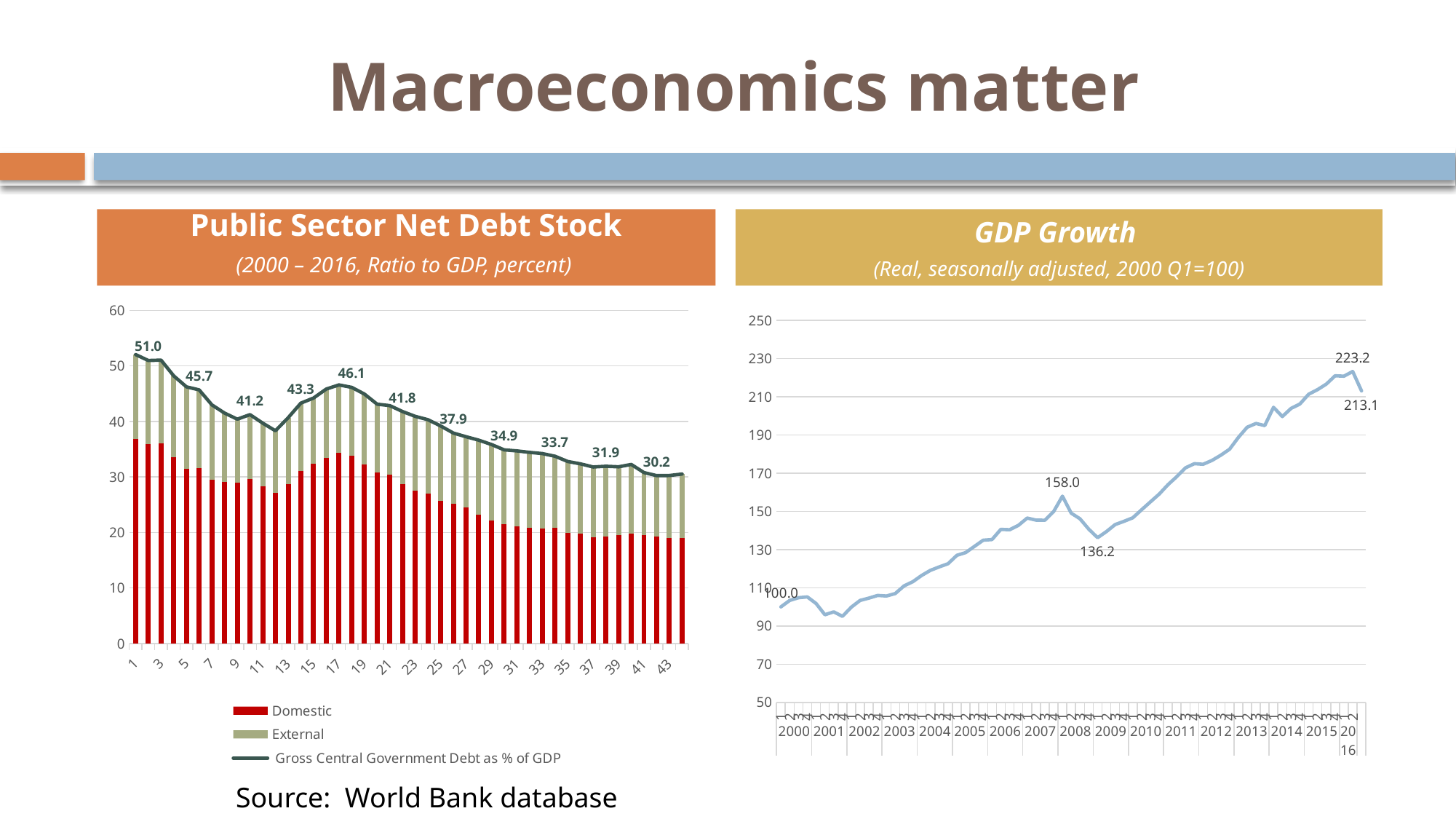
On the Public Sector Net Debt Stock chart, what is the difference between the first labelled value (51.0) and the last labelled value (30.2)? 20.8 On the Public Sector Net Debt Stock chart, which labelled value is larger, 43.3 or 46.1? 46.1 What kind of chart is the GDP Growth chart? line chart On the GDP Growth chart, what is the difference between the labelled values 158.0 and 136.2? 21.8 How many series does the legend of the Public Sector Net Debt Stock chart list? 3 On the Public Sector Net Debt Stock chart, what is the highest value labelled on the Gross Central Government Debt as % of GDP line? 51.0 On the Public Sector Net Debt Stock chart, what is the lowest value labelled on the Gross Central Government Debt as % of GDP line? 30.2 On the GDP Growth chart, does the line generally rise or fall from 2000 to 2016? rise On the GDP Growth chart, what is the difference between the labelled peak of 223.2 and the final labelled value of 213.1? 10.1 On the Public Sector Net Debt Stock chart, which colour represents Domestic in the legend? red On the Public Sector Net Debt Stock chart, does the Gross Central Government Debt line generally rise or fall from left to right? fall On the GDP Growth chart, what is the highest labelled value? 223.2